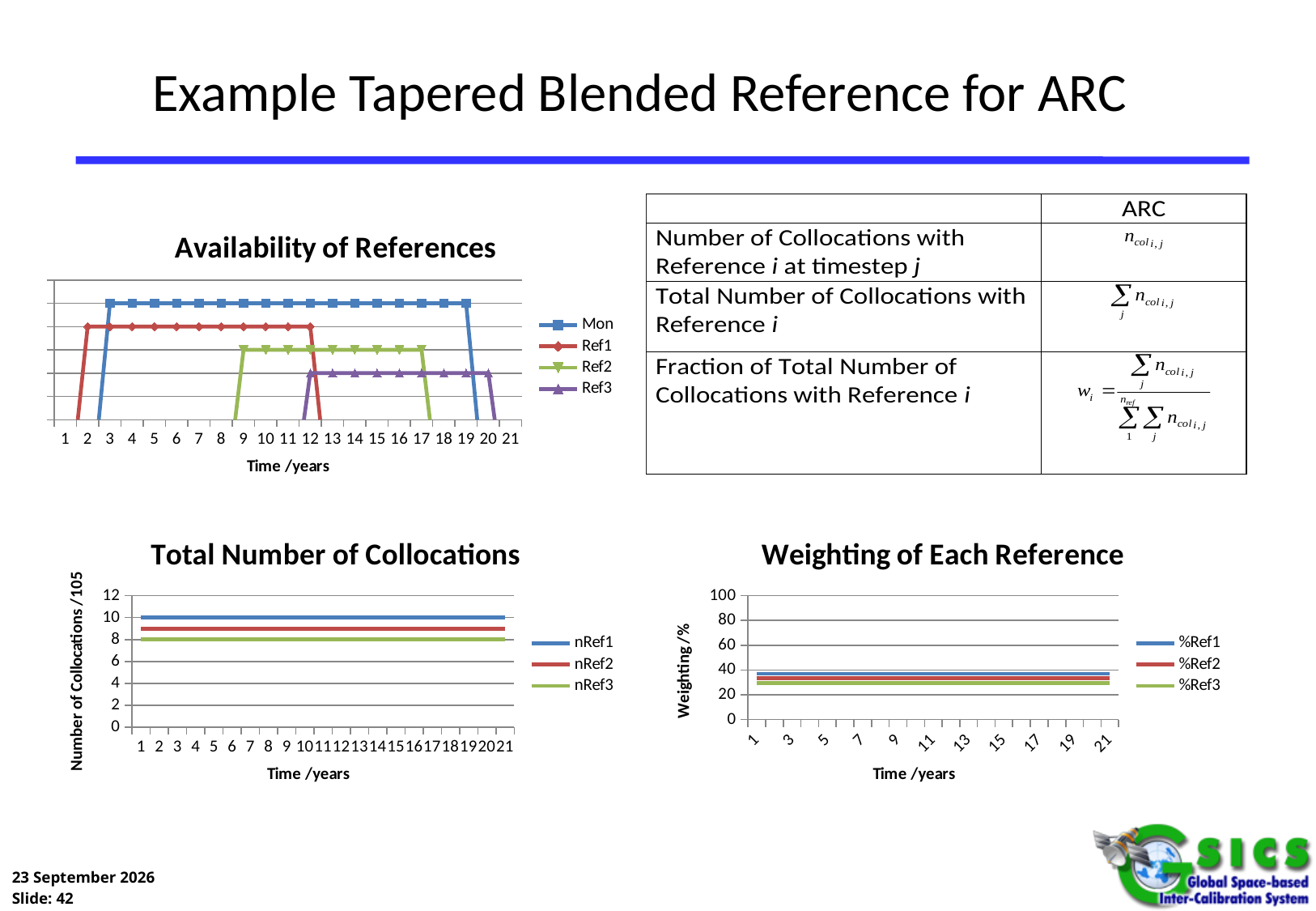
In the "Weighting of Each Reference" chart, is the value for %Ref1 greater or less than 60? less In the "Weighting of Each Reference" chart, is the value for %Ref3 greater or less than 20? greater In the "Total Number of Collocations" chart, what is the value of nRef1? 10 In the "Total Number of Collocations" chart, which series has the lowest value? nRef3 What kind of chart is the "Availability of References" chart? line chart How many series does the legend of the "Availability of References" chart list? 4 In the "Total Number of Collocations" chart, does the nRef1 line rise, fall or stay flat across the years? stays flat How many series does the legend of the "Total Number of Collocations" chart list? 3 How many time points are shown on the x axis of the "Total Number of Collocations" chart? 21 What is the y-axis title of the "Weighting of Each Reference" chart? Weighting /% In the "Total Number of Collocations" chart, what is the value of nRef3? 8 In the "Availability of References" chart, which series has the highest plotted level? Mon